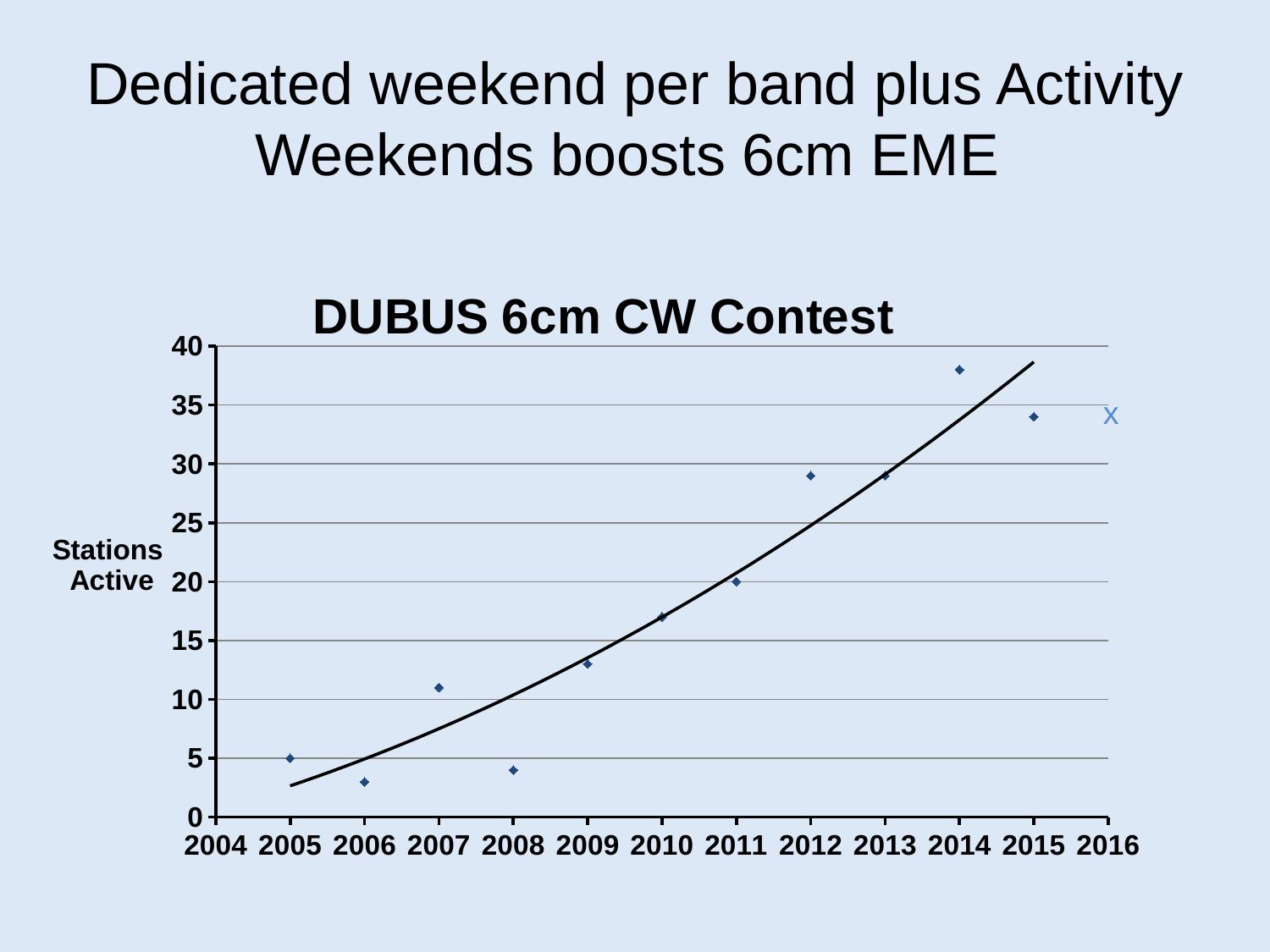
What kind of chart is shown on the slide? scatter chart Is the value for 2006 greater or less than 5? less Is the value for 2012 greater or less than 25? greater Which year has more stations active, 2007 or 2008? 2007 Do the number of stations active generally rise or fall from 2005 to 2014? rise Is the value for 2014 greater or less than 35? greater Which year has the highest number of stations active? 2014 How many stations were active in 2005? 5 How many stations were active in 2011? 20 What is the title of the chart? DUBUS 6cm CW Contest What is the label on the vertical axis of the chart? Stations Active Which year has more stations active, 2014 or 2015? 2014